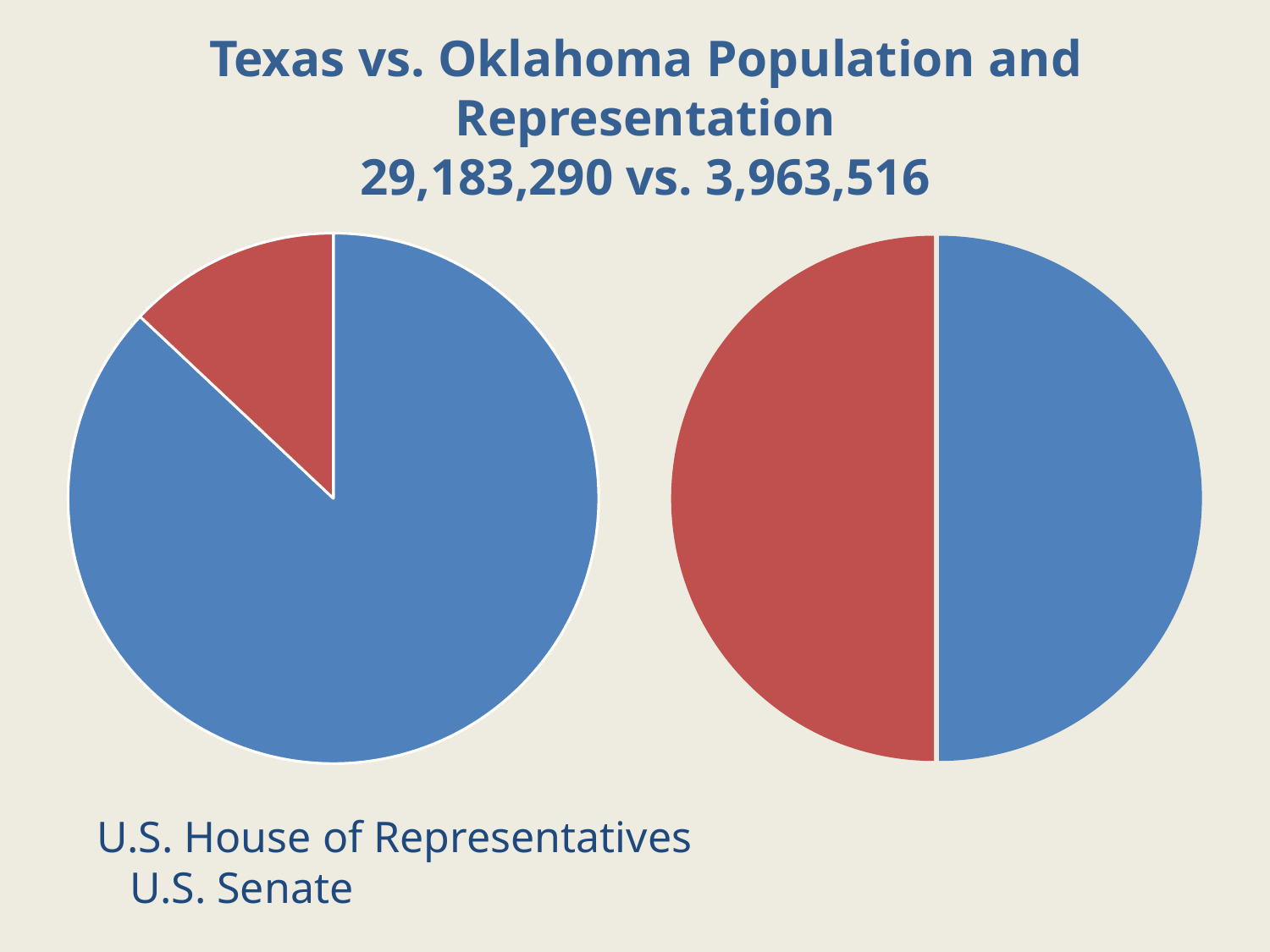
What population figures are shown in the slide title? 29,183,290 vs. 3,963,516 Which two states does the slide title compare? Texas and Oklahoma How many pie charts are on the slide? 2 How many slices does the left pie chart have? 2 What kind of chart is shown on the left side of the slide? pie chart Which pie chart has the larger red slice, the left one or the right one? right How many slices does the right pie chart have? 2 In the right pie chart, are the red and blue slices equal in size? yes In the left pie chart, is the red slice greater or less than a quarter of the pie? less In the left pie chart, is the blue slice greater or less than half of the pie? greater In the left pie chart, which slice is larger, the blue one or the red one? blue